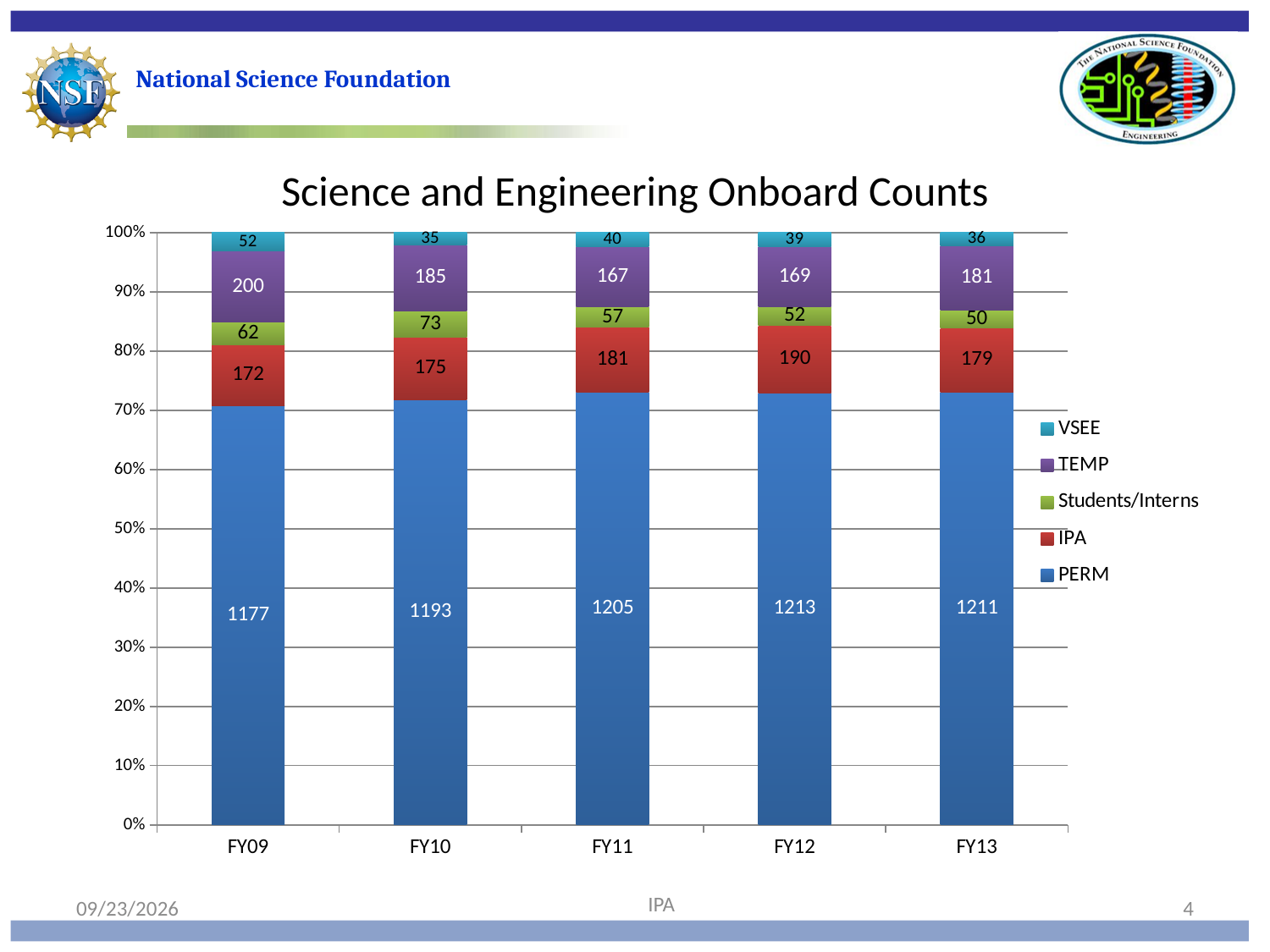
Which fiscal year has the lowest VSEE value? FY10 How many series does the legend list? 5 What is the total onboard count for FY12 across all five series? 1663 What is the PERM value for FY11? 1205 What is the IPA value for FY12? 190 What is the Students/Interns value for FY10? 73 What kind of chart is shown? 100% stacked bar chart How many fiscal years are shown on the x axis? 5 Which is larger, the IPA value for FY10 or the TEMP value for FY10? TEMP (185) What is the VSEE value for FY09? 52 Which fiscal year has the highest TEMP value? FY09 What is the difference between the PERM values for FY13 and FY09? 34